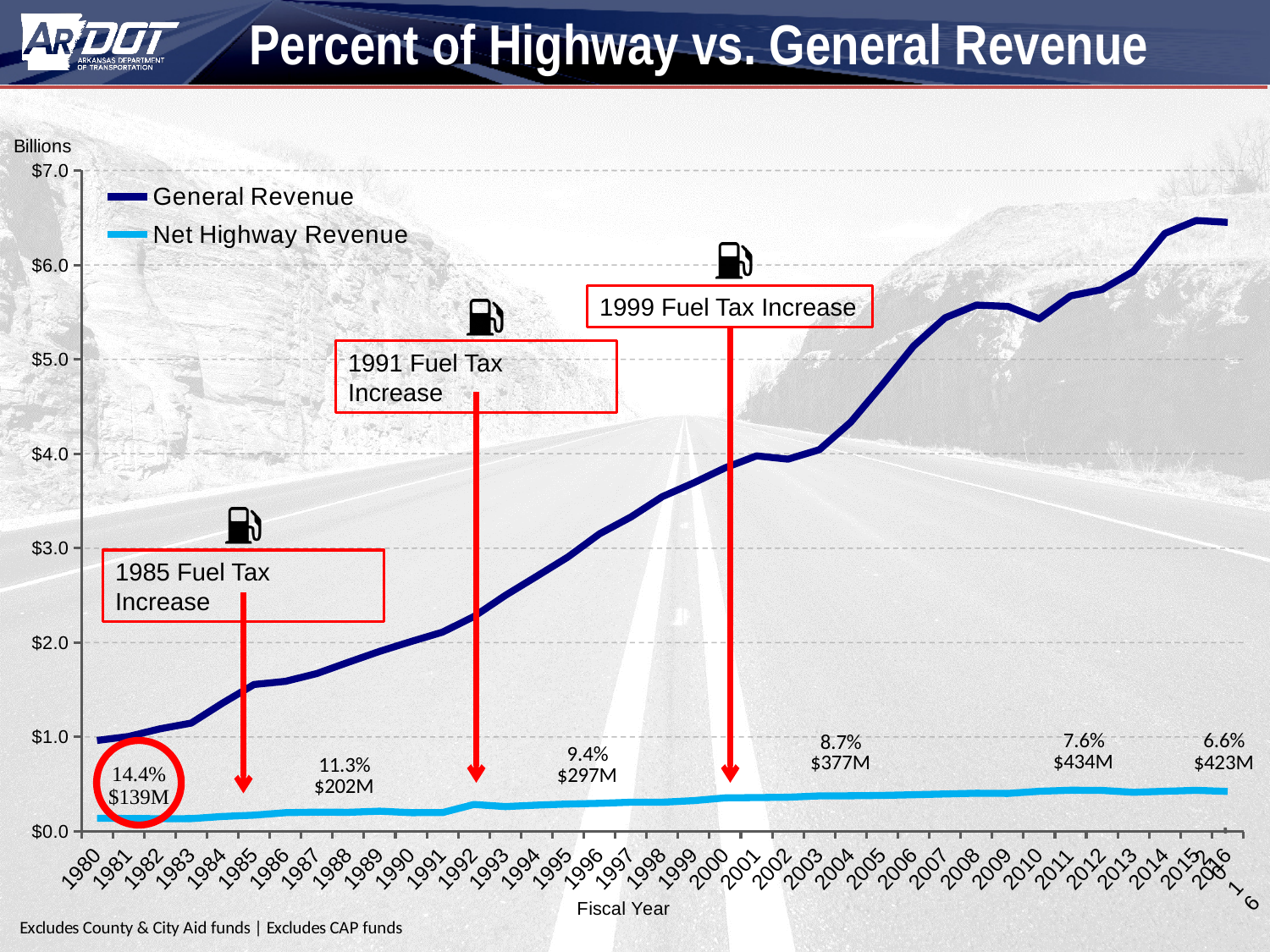
How many series does the legend list? 2 What are the two series named in the legend? General Revenue and Net Highway Revenue What percentage is printed above the $297M label? 9.4% What dollar amount is printed below the 7.6% label? $434M What net highway revenue amount is printed next to the 14.4% label circled at 1980? $139M Is the General Revenue value for 2016 greater or less than $6.0 billion? greater Does General Revenue generally rise or fall from 1980 to 2016? rise What is the title of the chart? Percent of Highway vs. General Revenue Is the General Revenue value for 1985 greater or less than $2.0 billion? less What kind of chart is shown on the slide? line chart What is the difference between the $434M and $423M net highway revenue labels? $11M In 2016, which series has the larger value, General Revenue or Net Highway Revenue? General Revenue